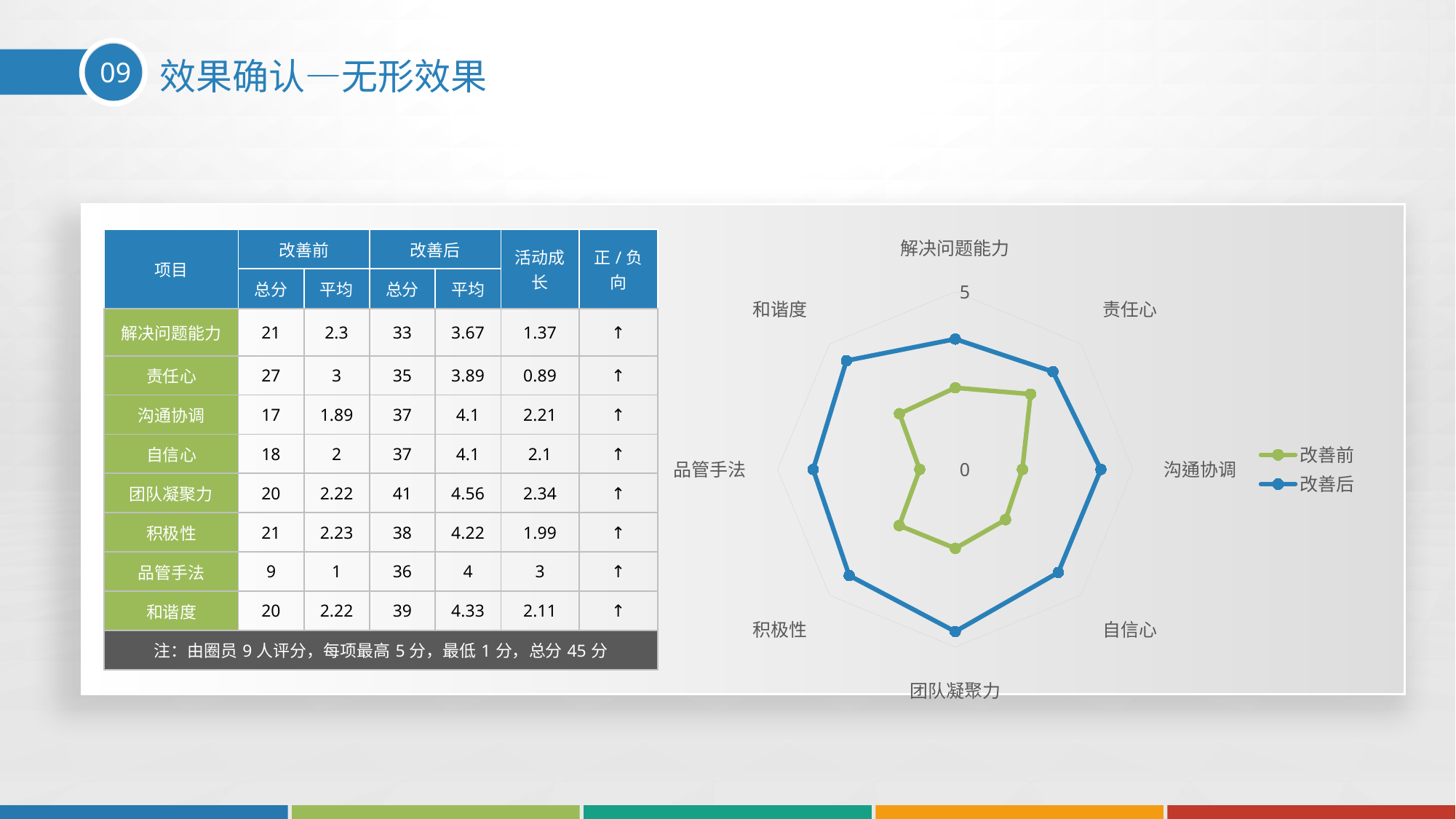
Which colour represents the 改善后 series in the radar chart? Blue In the radar chart, which is larger for the 改善前 series: 责任心 or 品管手法? 责任心 In the radar chart, which series has the larger value for 沟通协调, 改善前 or 改善后? 改善后 How many categories (axes) does the radar chart have? 8 In the radar chart, which category has the lowest 改善前 value? 品管手法 In the radar chart, which category has the highest 改善前 value? 责任心 In the radar chart, is the 改善后 value for 团队凝聚力 greater or less than 5? less In the radar chart, is the 改善前 value for 品管手法 greater or less than 5? less What kind of chart is shown on the right of the slide? Radar chart What are the two series named in the radar chart's legend? 改善前 and 改善后 What is the maximum value shown on the radar chart's axis scale? 5 How many series does the radar chart's legend list? 2